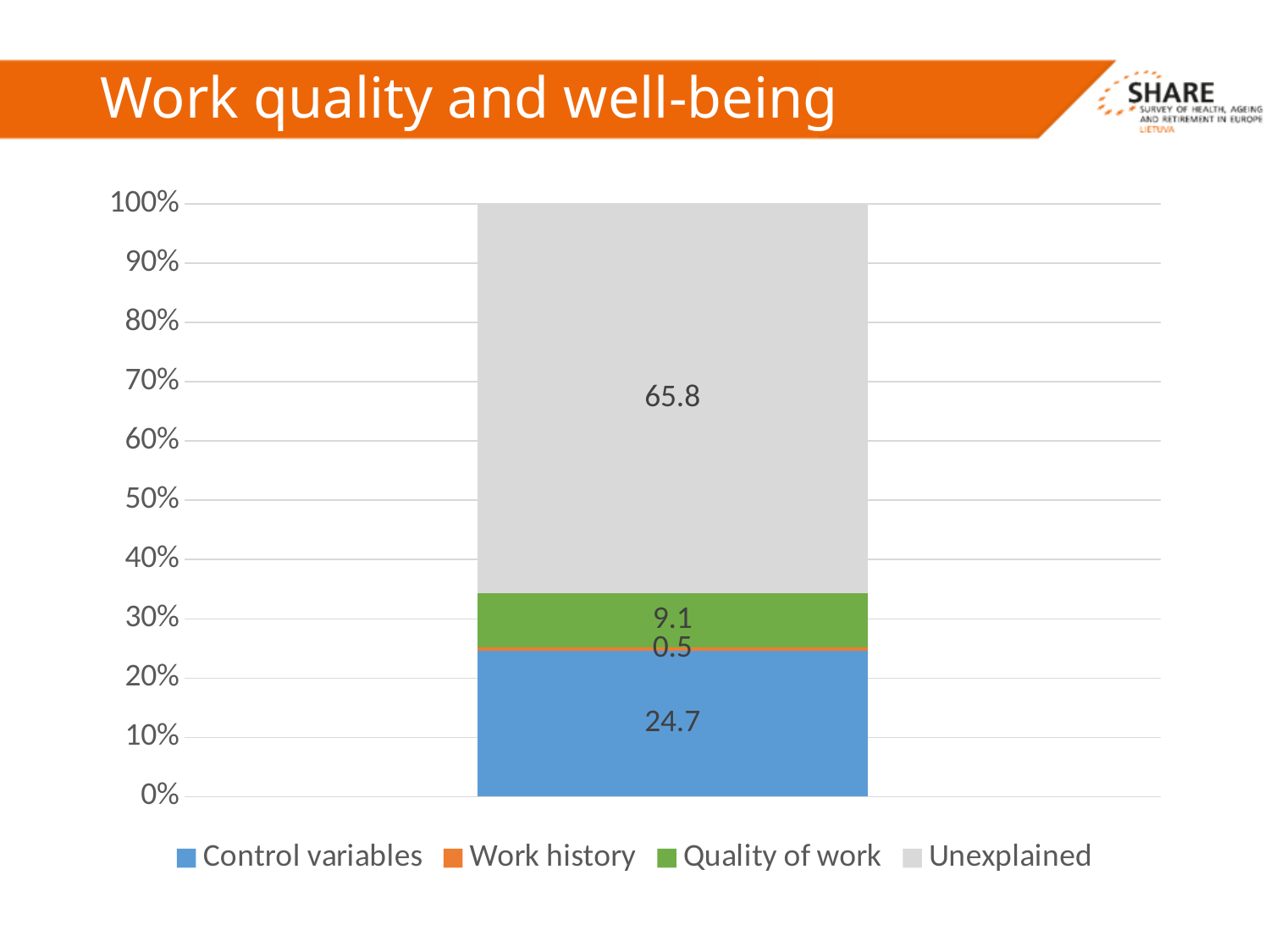
What is the difference between the Quality of work value and the Work history value? 8.6 Which is larger, the value for Control variables or the value for Quality of work? Control variables What kind of chart is shown on the slide? Stacked bar chart What is the total of the stacked bar's labelled values? 100.1 Which series has the largest value in the stacked bar? Unexplained What is the value for Quality of work? 9.1 Which series has the smallest value in the stacked bar? Work history What is the value for Unexplained? 65.8 What is the value for Control variables? 24.7 How many series does the legend list? 4 What is the value for Work history? 0.5 What is the difference between the Unexplained value and the Control variables value? 41.1